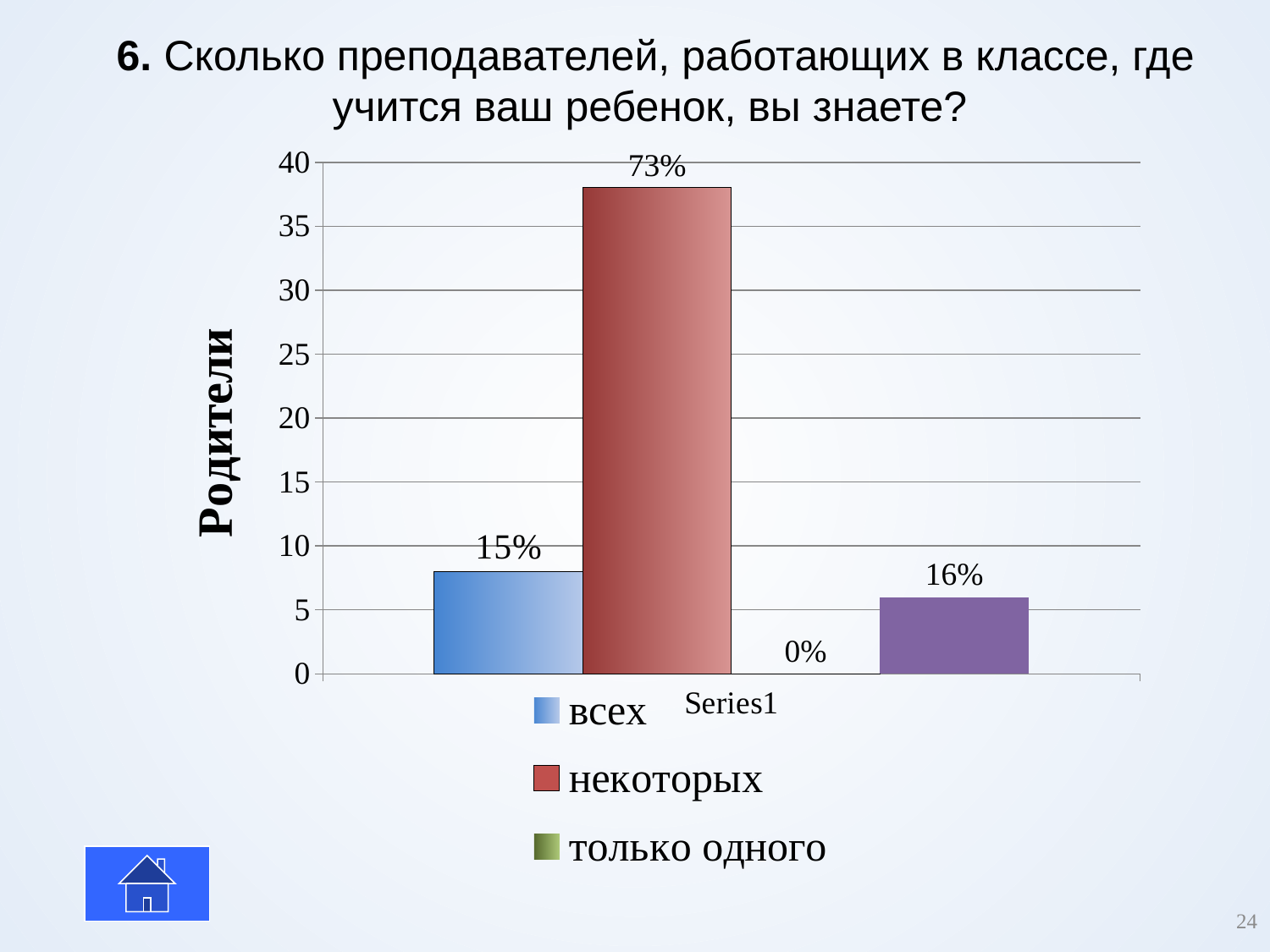
Which is larger, the value for 'всех' or for 'некоторых'? некоторых What is the difference between the 'некоторых' value and the 'всех' value? 58% Which legend category has the lowest value? только одного What is the value shown for the 'всех' bar? 15% How many entries does the legend list? 3 What is the value shown for 'только одного'? 0% Is the height of the 'всех' bar on the y axis greater or less than 10? less Is the height of the 'некоторых' bar on the y axis greater or less than 35? greater What is the label on the vertical axis of the chart? Родители What is the value shown for the 'некоторых' bar? 73% What kind of chart is shown on the slide? bar chart Which legend category has the highest value? некоторых